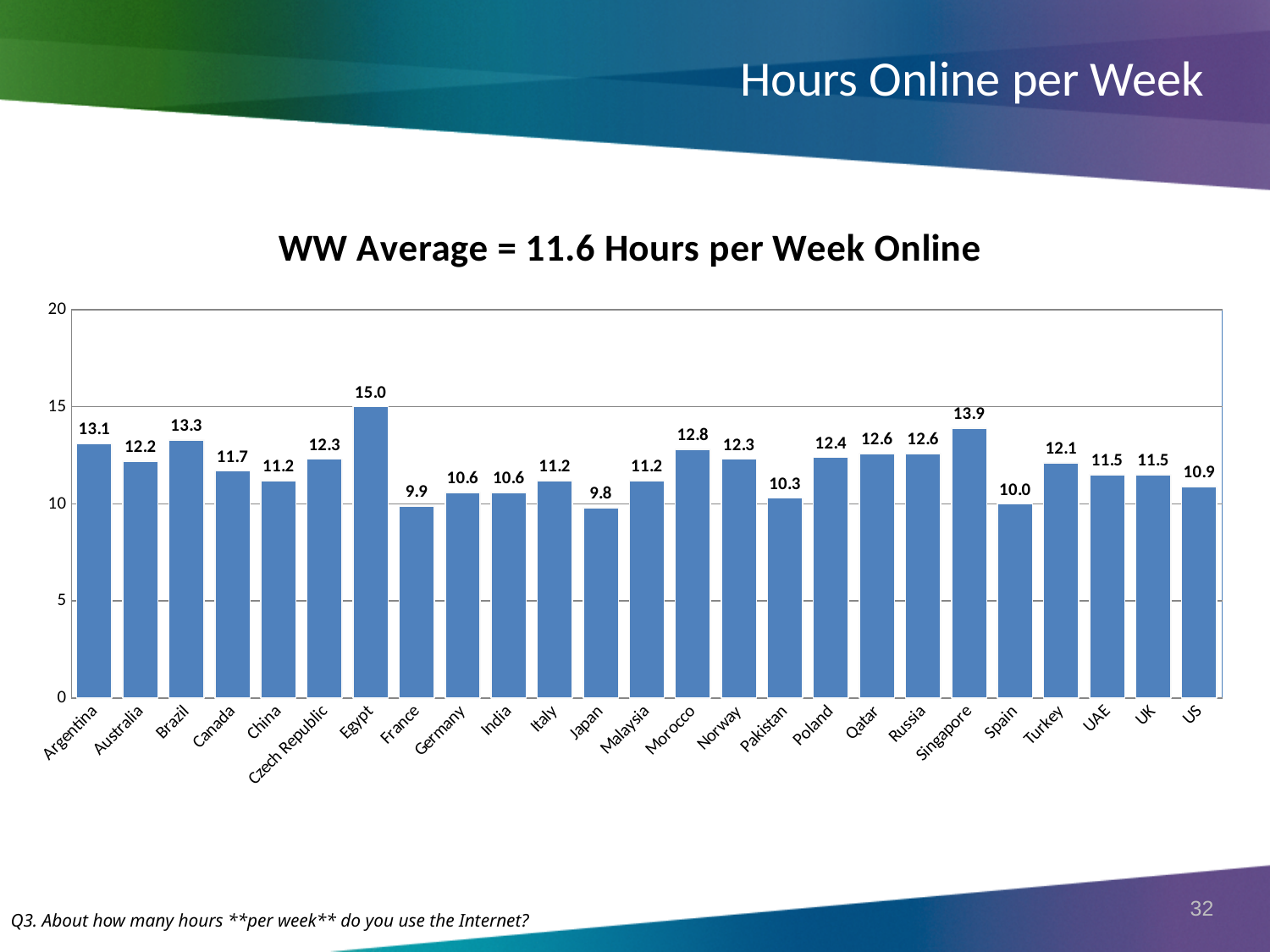
What is the value for Singapore? 13.9 What is the difference between the values for Egypt and Japan? 5.2 What is the difference between the values for Singapore and Spain? 3.9 What is the value for Pakistan? 10.3 Which has a larger value, Morocco or Pakistan? Morocco Which country has the highest value? Egypt Which has a larger value, Brazil or Argentina? Brazil Which country has the lowest value? Japan Is the value for Singapore greater or less than 10? greater What is the value for Egypt? 15.0 What kind of chart is shown on the slide? Bar chart How many countries are shown in the chart? 25